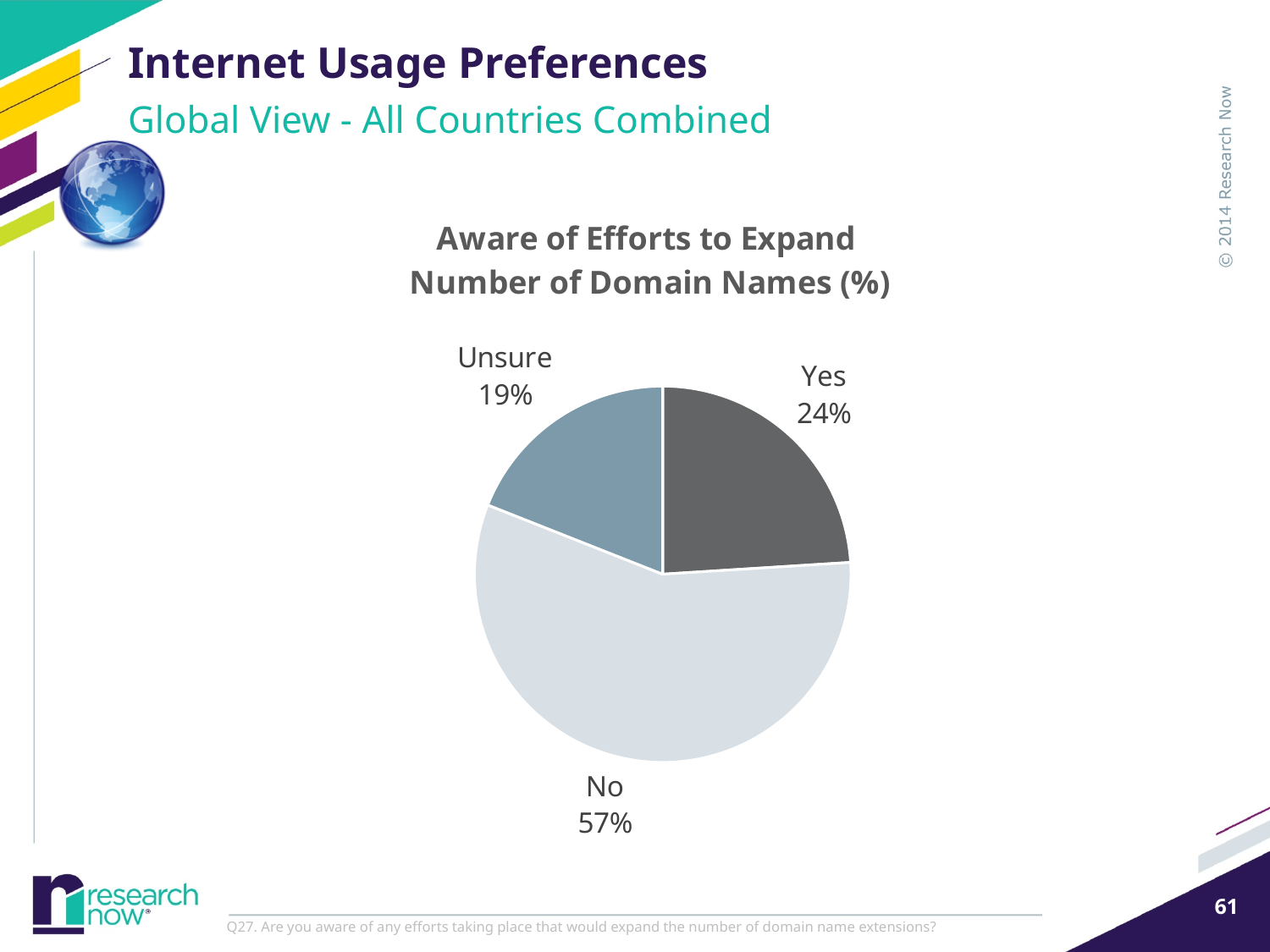
What is the title of the chart? Aware of Efforts to Expand Number of Domain Names (%) What share of the pie does the No slice represent? 57% What percentage of respondents answered No? 57% Which is larger, the share for Yes or the share for Unsure? Yes What is the difference in percentage points between No and Yes? 33 What is the difference in percentage points between Yes and Unsure? 5 How many slices does the pie chart have? 3 Which response has the largest share of the pie? No What kind of chart is shown on the slide? pie chart What percentage of respondents answered Unsure? 19% What percentage of respondents answered Yes? 24% Which response has the smallest share of the pie? Unsure